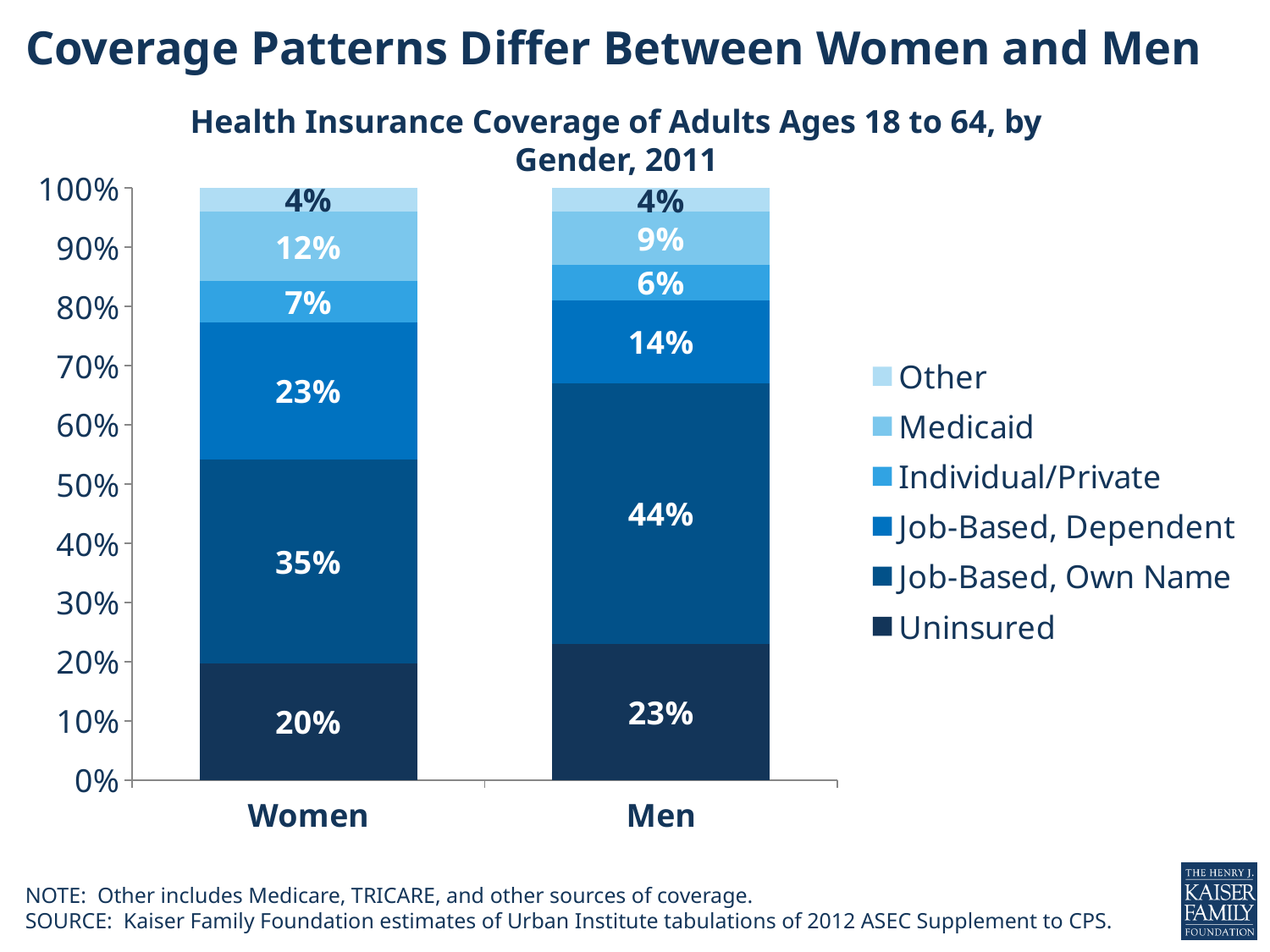
What kind of chart is shown? Stacked bar chart What is the Individual/Private value for women? 7% What is the Job-Based, Dependent value for men? 14% Which gender has the higher uninsured percentage? Men What is the difference between the Job-Based, Dependent values for women and men? 9 percentage points What percentage of women are uninsured? 20% What percentage of men have job-based coverage in their own name? 44% What is the Medicaid share for women? 12% Which coverage category is the largest for men? Job-Based, Own Name Which gender has the higher Medicaid percentage? Women What is the title of the chart? Health Insurance Coverage of Adults Ages 18 to 64, by Gender, 2011 How many series does the legend list? 6